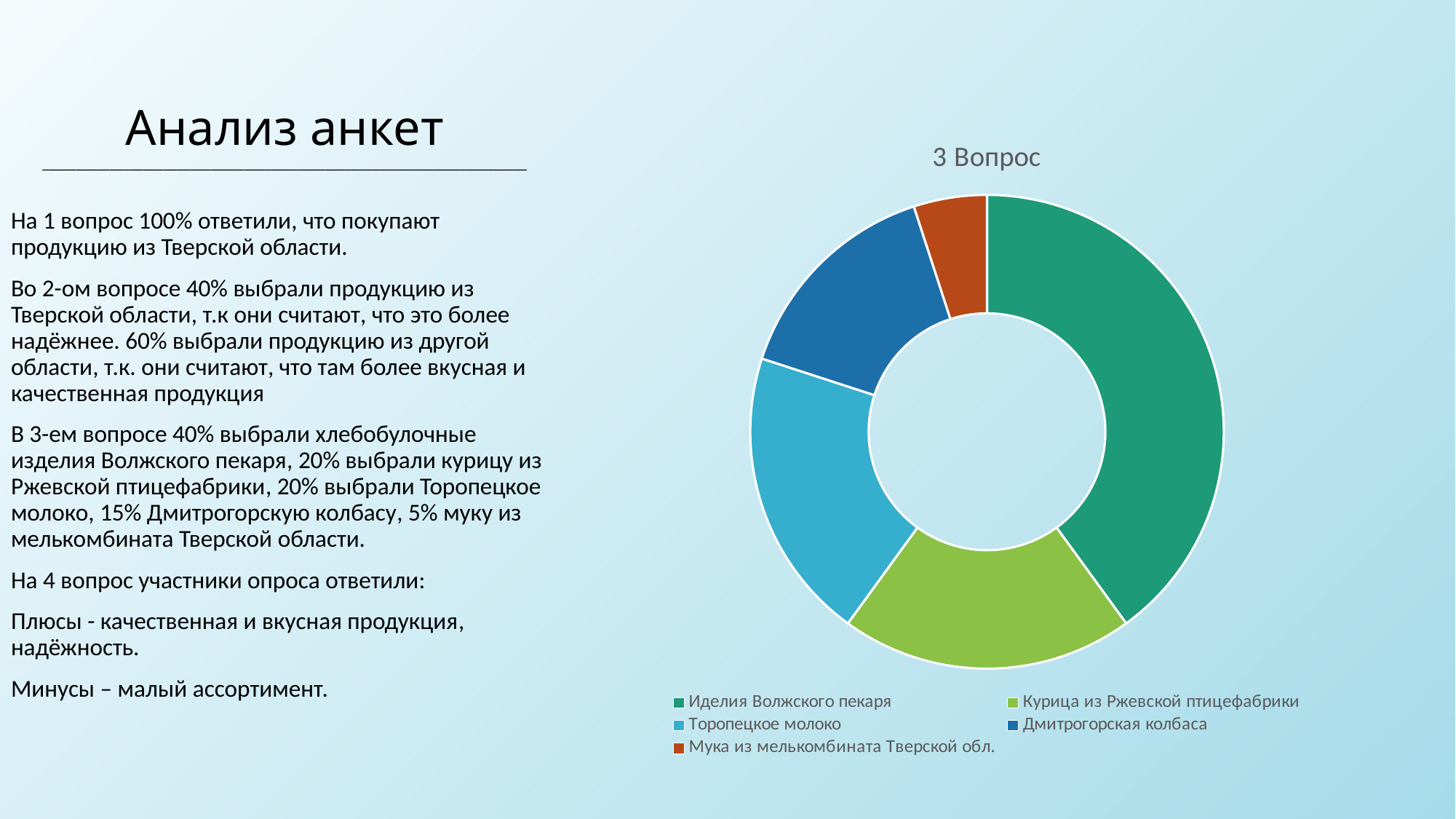
Which category has the largest slice in the chart? Иделия Волжского пекаря How many categories does the chart show? 5 Which slice is larger: Курица из Ржевской птицефабрики or Мука из мелькомбината Тверской обл.? Курица из Ржевской птицефабрики Which slice is larger: Торопецкое молоко or Дмитрогорская колбаса? Торопецкое молоко Which category has the smallest slice in the chart? Мука из мелькомбината Тверской обл. Which slice is larger: Дмитрогорская колбаса or Мука из мелькомбината Тверской обл.? Дмитрогорская колбаса Which category is shown in orange in the chart? Мука из мелькомбината Тверской обл. What is the title of the chart? 3 Вопрос What kind of chart is shown on the slide? Doughnut (pie) chart